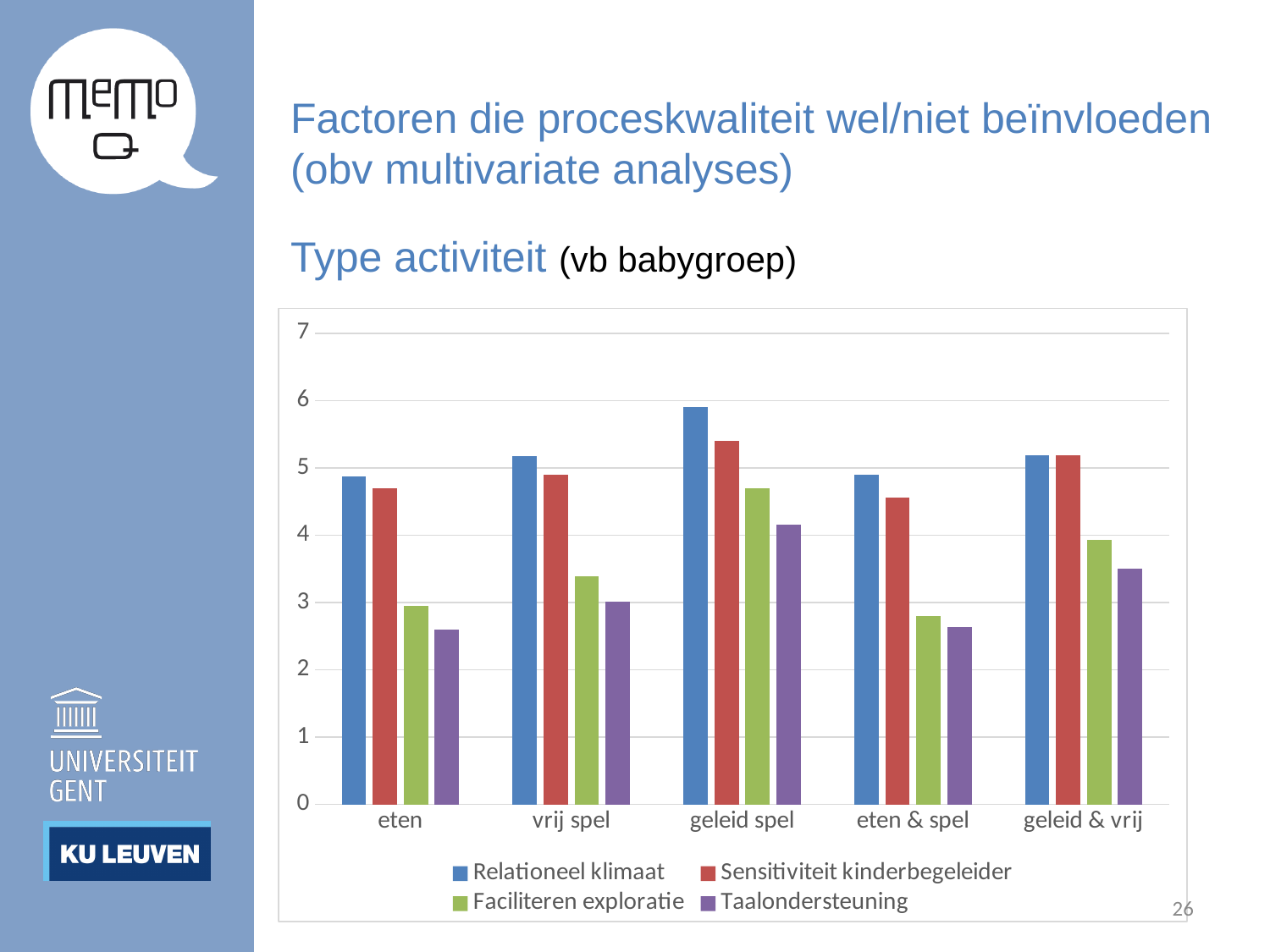
Is the Taalondersteuning value for eten greater or less than 3? less Is the Relationeel klimaat value for geleid spel greater or less than 5? greater For which activity is the Taalondersteuning bar the highest? geleid spel Is the Sensitiviteit kinderbegeleider value for eten & spel greater or less than 5? less Which colour represents Sensitiviteit kinderbegeleider in the chart's legend? red For which activity is the Relationeel klimaat bar the highest? geleid spel For which activity is the Faciliteren exploratie bar the highest? geleid spel For vrij spel, which is larger: Faciliteren exploratie or Taalondersteuning? Faciliteren exploratie How many series does the chart's legend list? 4 How many activity categories are shown on the x axis of the chart? 5 What kind of chart is shown on the slide? bar chart